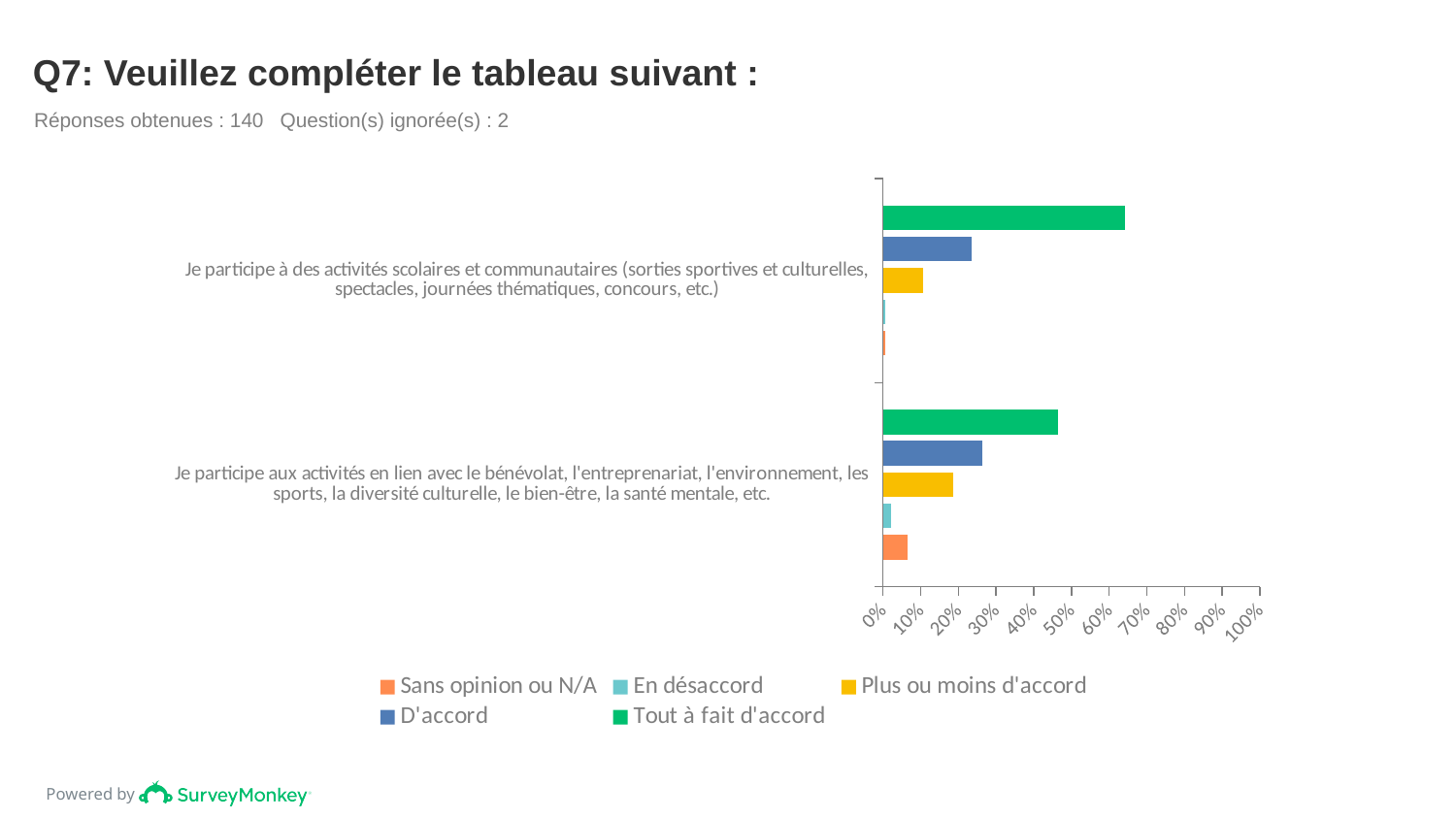
Is the value for 'Tout à fait d'accord' for 'Je participe à des activités scolaires et communautaires' greater or less than 60%? greater How many responses were obtained according to the slide? 140 How many categories (statements) are plotted in the chart? 2 Is the value for 'Tout à fait d'accord' for 'Je participe aux activités en lien avec le bénévolat' greater or less than 50%? less Which statement has the larger 'Tout à fait d'accord' value? Je participe à des activités scolaires et communautaires For 'Je participe aux activités en lien avec le bénévolat', which response series has the highest value? Tout à fait d'accord What kind of chart is shown on the slide? bar chart Is the value for 'Sans opinion ou N/A' for 'Je participe aux activités en lien avec le bénévolat' greater or less than 10%? less How many series does the legend list? 5 Which statement has the larger 'Plus ou moins d'accord' value? Je participe aux activités en lien avec le bénévolat What is the title of the slide? Q7: Veuillez compléter le tableau suivant :